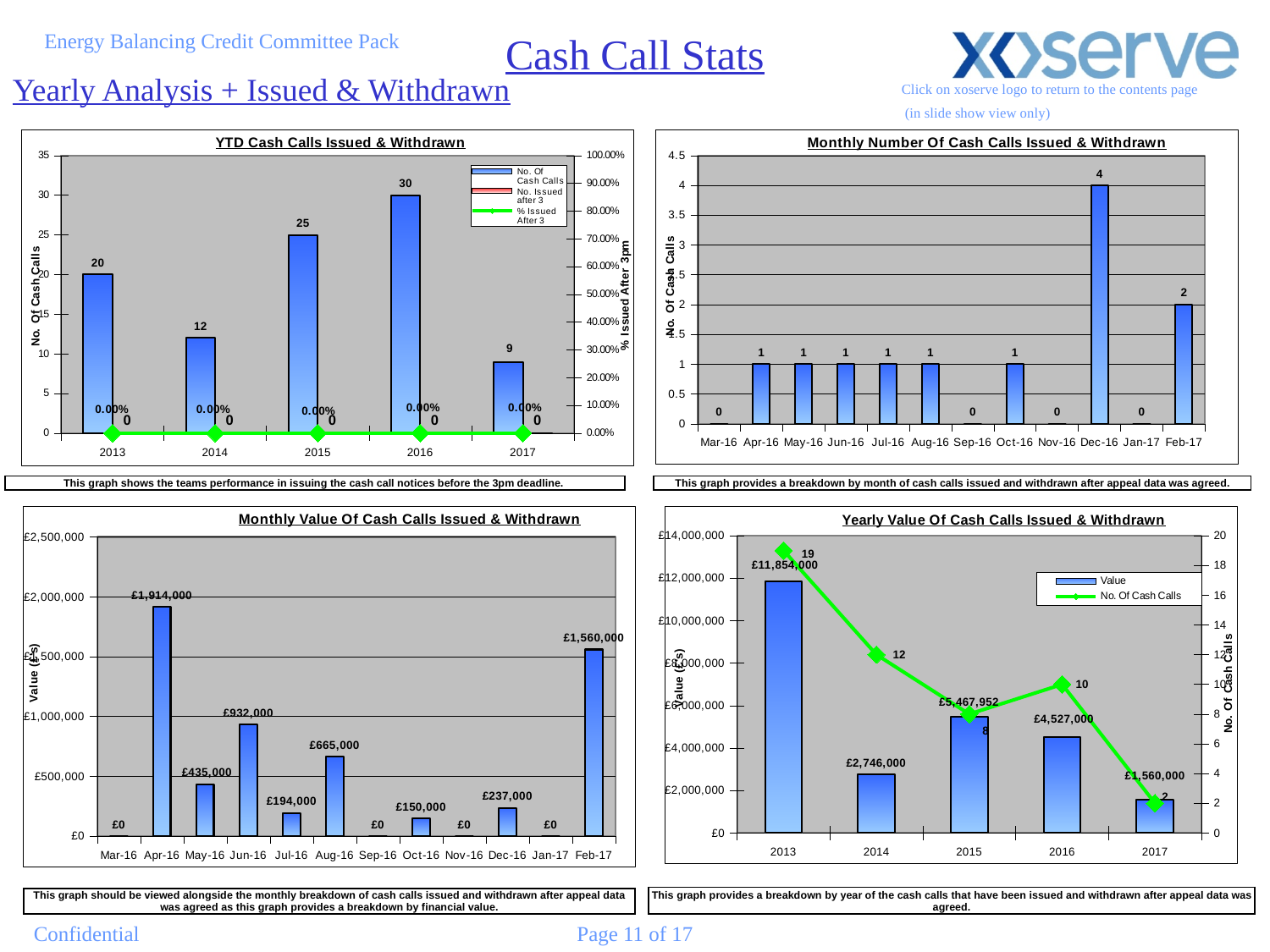
In the 'YTD Cash Calls Issued & Withdrawn' chart, what is the difference between the number of cash calls in 2015 and 2014? 13 In the 'Monthly Number Of Cash Calls Issued & Withdrawn' chart, what is the value for Dec-16? 4 In the 'Yearly Value Of Cash Calls Issued & Withdrawn' chart, what is the value for 2015? £5,467,952 How many series does the legend of the 'YTD Cash Calls Issued & Withdrawn' chart list? 3 What kind of chart is the 'Monthly Value Of Cash Calls Issued & Withdrawn' chart? Bar chart In the 'Monthly Value Of Cash Calls Issued & Withdrawn' chart, what is the value for Jun-16? £932,000 In the 'YTD Cash Calls Issued & Withdrawn' chart, what is the number of cash calls for 2016? 30 In the 'Yearly Value Of Cash Calls Issued & Withdrawn' chart, what is the number of cash calls for 2014? 12 In the 'Monthly Value Of Cash Calls Issued & Withdrawn' chart, which month has the highest value? Apr-16 How many months are shown on the x axis of the 'Monthly Number Of Cash Calls Issued & Withdrawn' chart? 12 In the 'Monthly Value Of Cash Calls Issued & Withdrawn' chart, which is larger, the value for Aug-16 or the value for May-16? Aug-16 In the 'YTD Cash Calls Issued & Withdrawn' chart, which year has the lowest number of cash calls? 2017